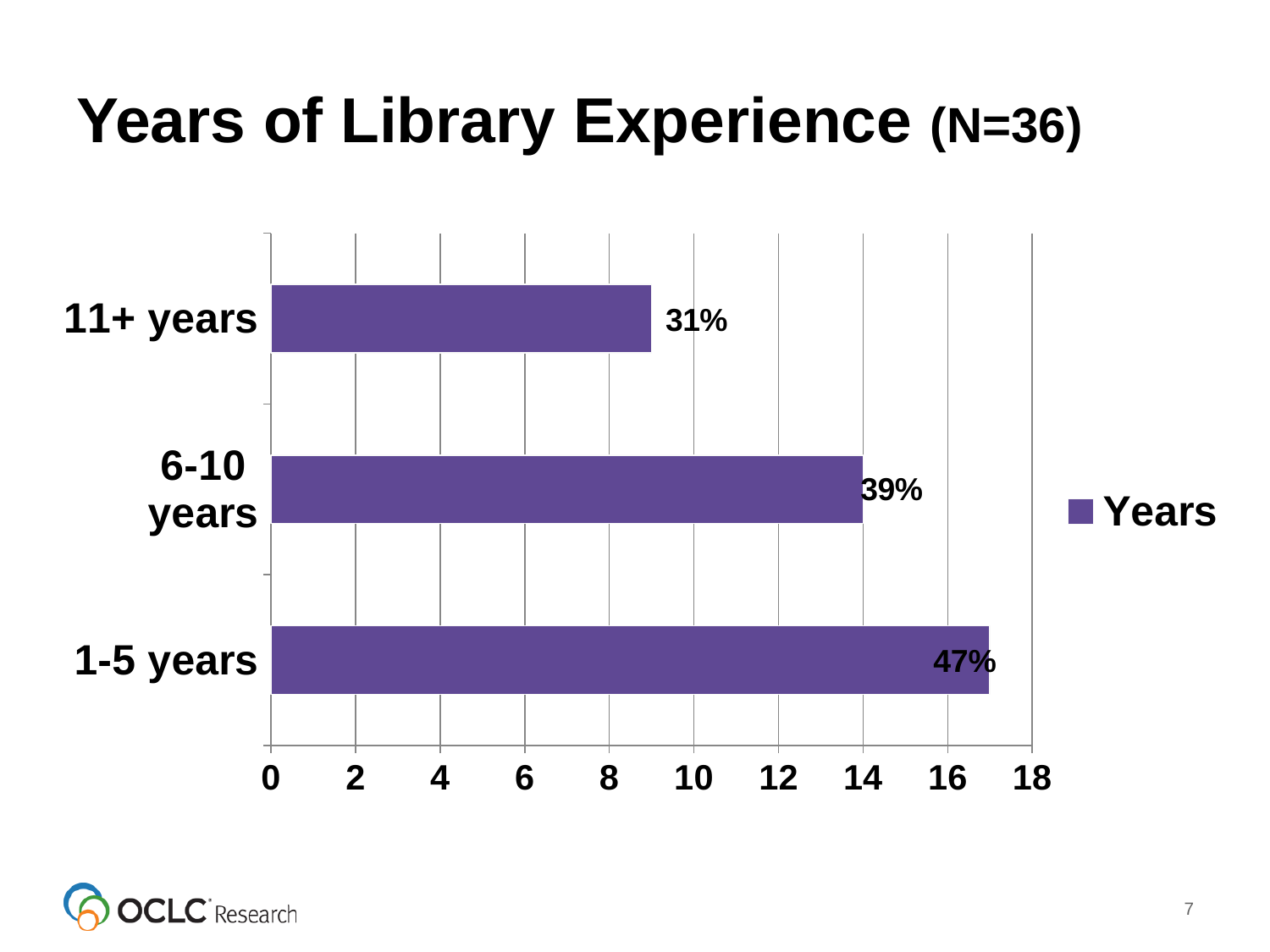
Which category has the highest value? 1-5 years What is the name of the series listed in the legend? Years What is the data label shown for the 6-10 years category? 39% Is the bar for 1-5 years greater or less than 16 on the axis? greater Which is larger, the value for 6-10 years or the value for 11+ years? 6-10 years What kind of chart is shown on the slide? Bar chart Which category has the lowest value? 11+ years Is the bar for 11+ years greater or less than 10 on the axis? less How many categories are shown in the chart? 3 What is the data label shown for the 11+ years category? 31% What is the data label shown for the 1-5 years category? 47% What is the difference between the percentage labels for 1-5 years and 11+ years? 16 percentage points